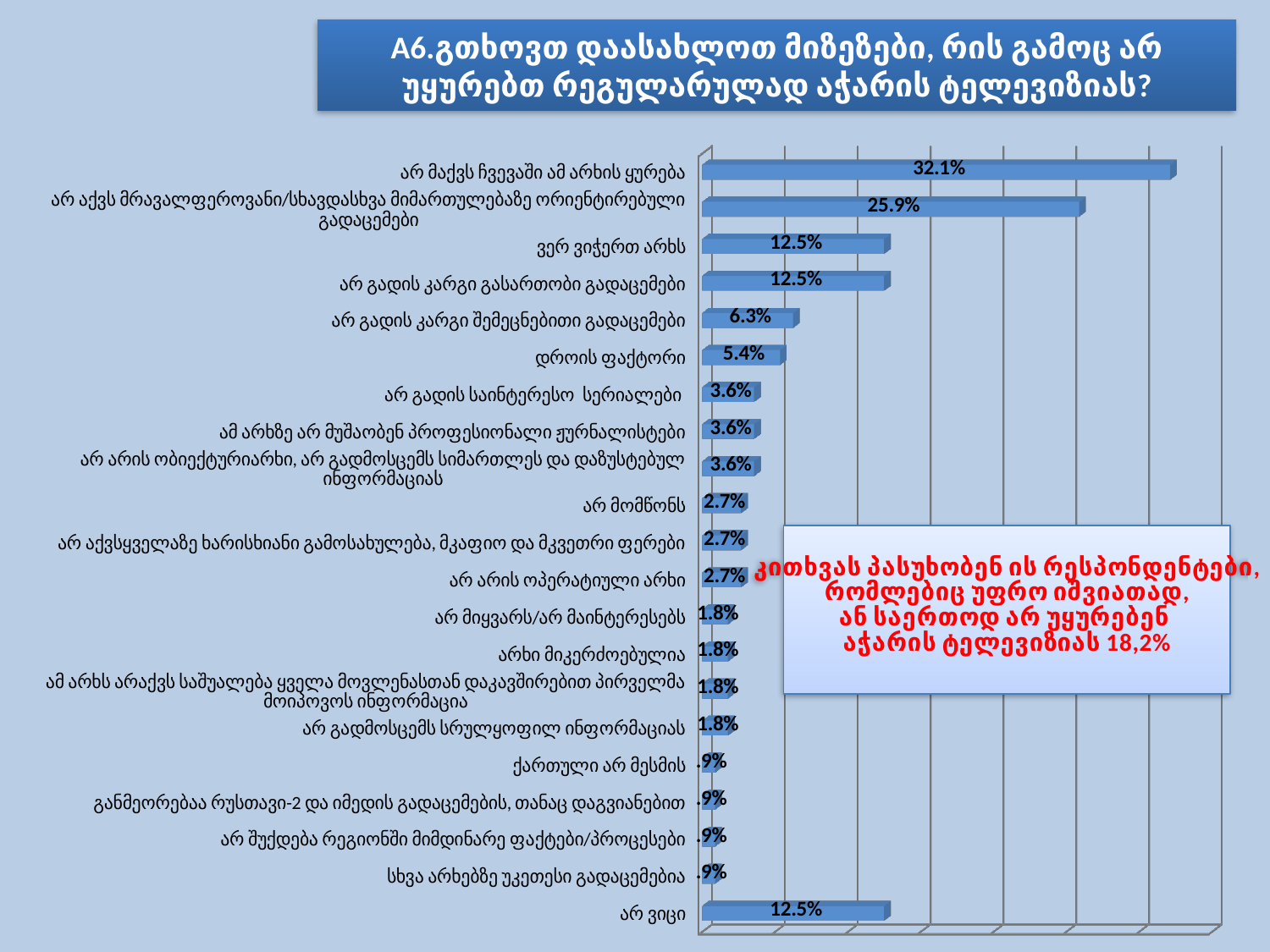
What percentage is stated in the red text box on the chart for respondents who watch rarely or never watch Adjara TV? 18,2% What is the value for "არ ვიცი"? 12.5% What is the value for "ქართული არ მესმის"? .9% What kind of chart is shown on the slide? bar chart Which is larger, the value for "დროის ფაქტორი" or the value for "არ მომწონს"? დროის ფაქტორი What is the value for "დროის ფაქტორი"? 5.4% What is the value for "არ გადის კარგი შემეცნებითი გადაცემები"? 6.3% What is the difference between the values for "ვერ ვიჭერთ არხს" and "არ გადის კარგი შემეცნებითი გადაცემები"? 6.2% What is the difference between the values for "არ მაქვს ჩვევაში ამ არხის ყურება" and "არ აქვს მრავალფეროვანი/სხვადასხვა მიმართულებაზე ორიენტირებული გადაცემები"? 6.2% How many categories (bars) does the chart show? 21 What is the value for "არ მაქვს ჩვევაში ამ არხის ყურება"? 32.1% Which category has the highest value? არ მაქვს ჩვევაში ამ არხის ყურება